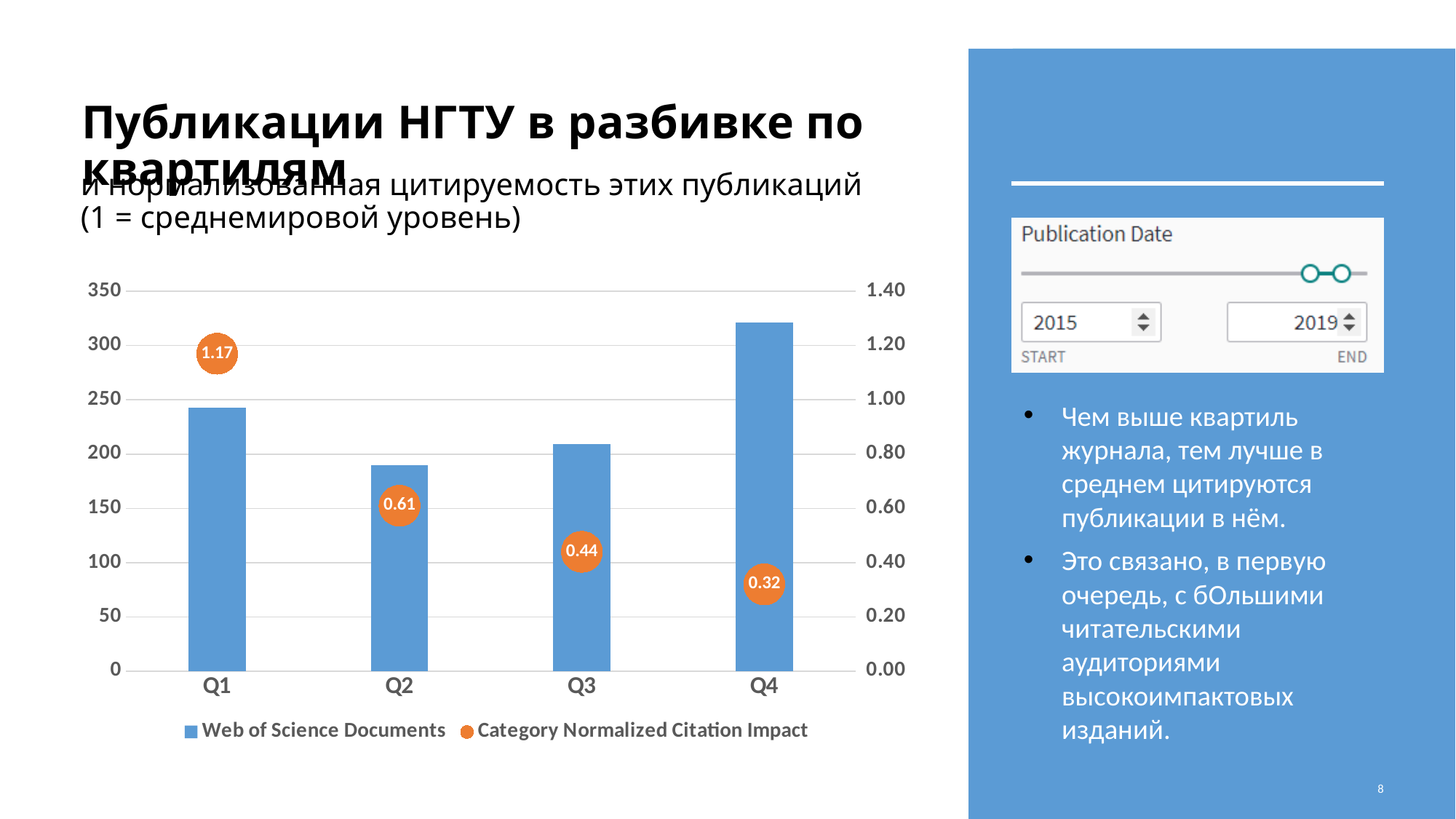
Is the number of Web of Science Documents for Q2 greater or less than 200? less What is the difference between the Category Normalized Citation Impact for Q1 and Q4? 0.85 How many series does the chart legend list? 2 Does the Category Normalized Citation Impact rise or fall from Q1 to Q4? fall What is the Category Normalized Citation Impact for Q2? 0.61 Which quartile has the highest number of Web of Science Documents? Q4 Which quartile has the highest Category Normalized Citation Impact? Q1 Which quartile has the lowest number of Web of Science Documents? Q2 Is the number of Web of Science Documents for Q4 greater or less than 300? greater What is the Category Normalized Citation Impact for Q4? 0.32 What is the Category Normalized Citation Impact for Q1? 1.17 Which quartile has the lowest Category Normalized Citation Impact? Q4